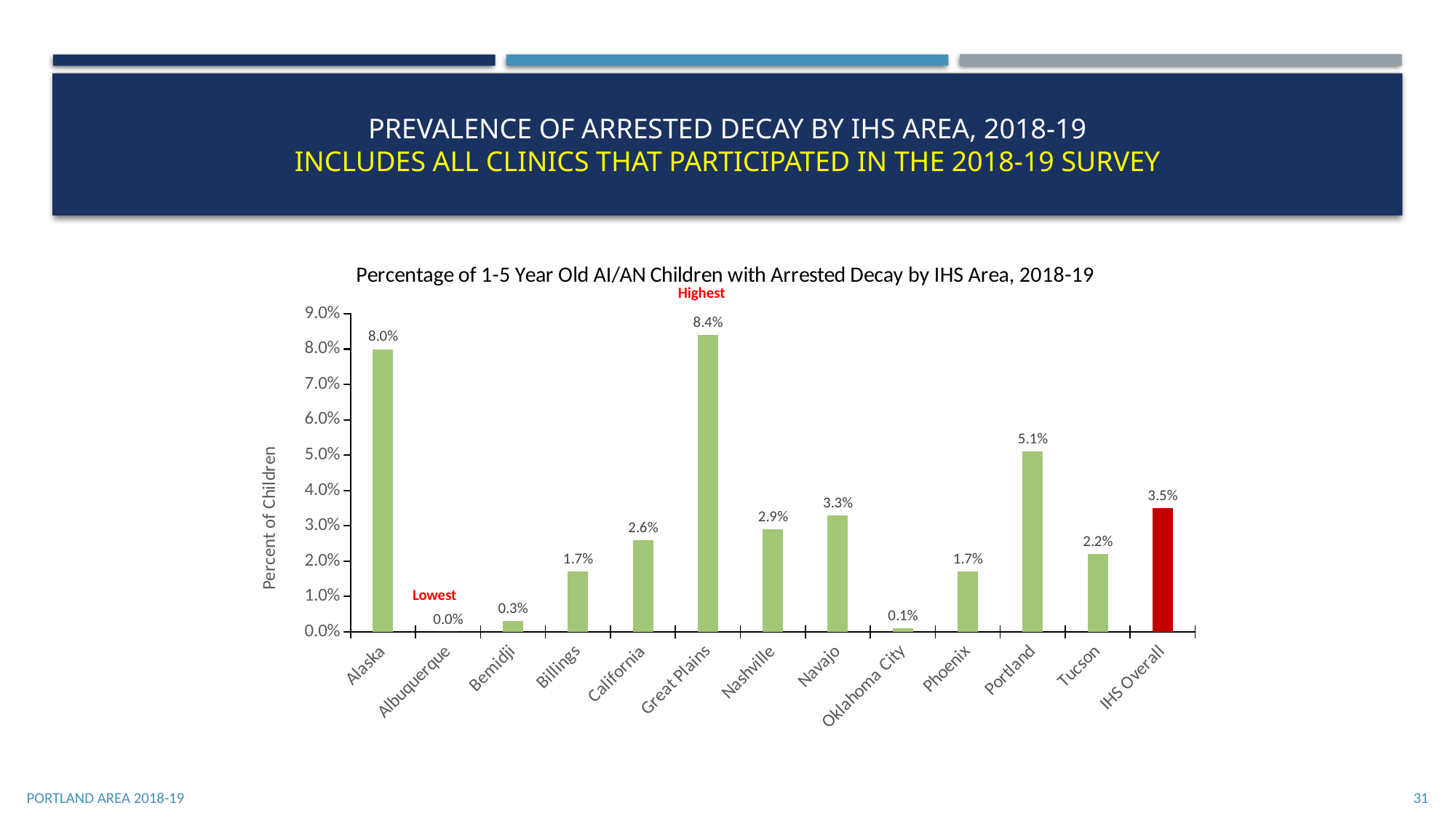
What is the value for Great Plains? 8.4% What kind of chart is shown on the slide? Bar chart What is the value for IHS Overall? 3.5% Which IHS area has the lowest percentage of children with arrested decay? Albuquerque How many categories are shown on the x axis? 13 What is the value for Portland? 5.1% Is the value for Portland greater or less than 4.0%? greater Which IHS area has the highest percentage of children with arrested decay? Great Plains Which bar is coloured red instead of green? IHS Overall What is the difference between the values for Great Plains and Alaska? 0.4% What is the label of the y axis? Percent of Children Which is larger, the value for Navajo or the value for Nashville? Navajo